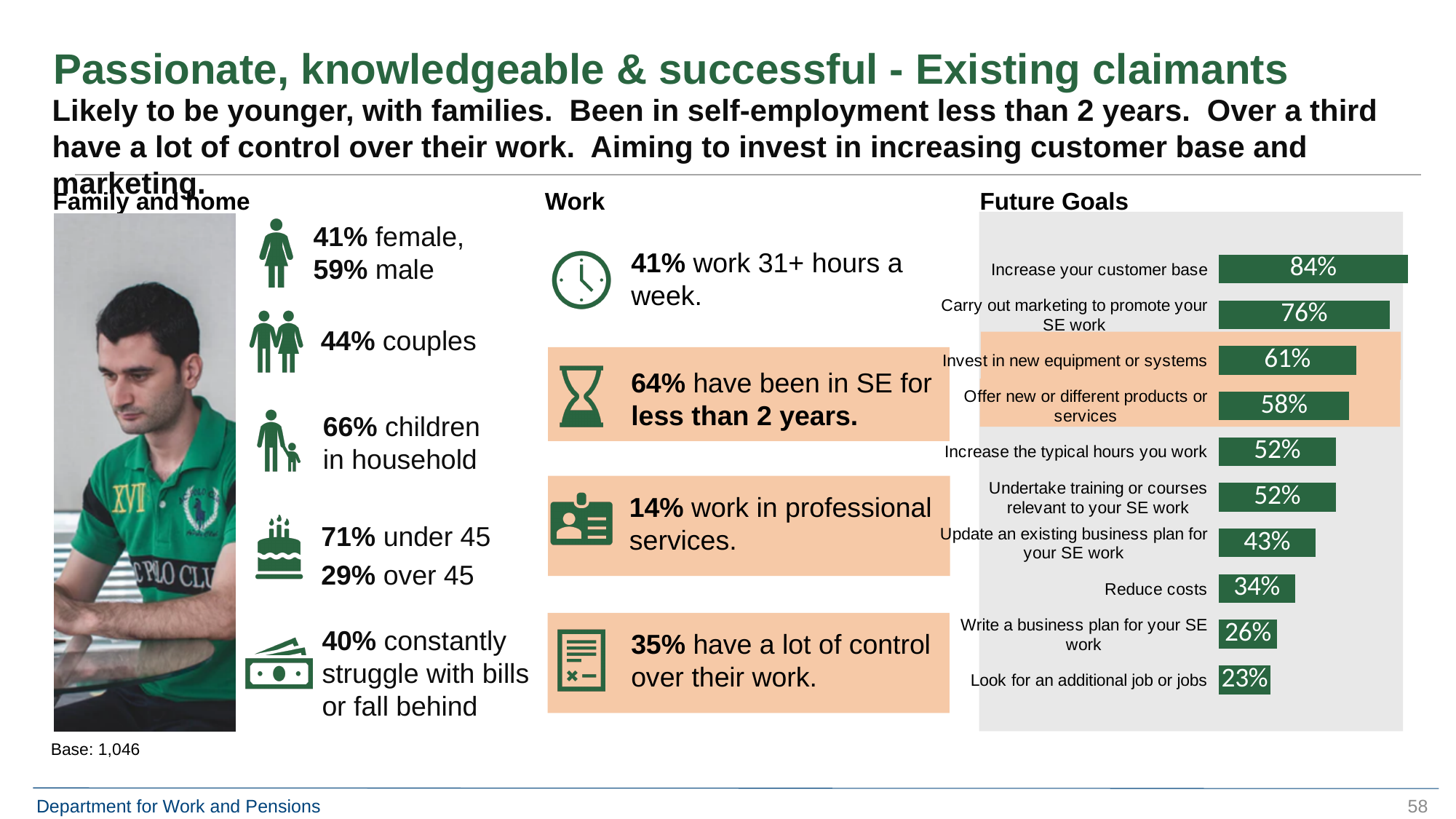
In the Future Goals chart, what is the difference between 'Increase your customer base' and 'Carry out marketing to promote your SE work'? 8% In the Future Goals chart, which goal has the lowest percentage? Look for an additional job or jobs In the Future Goals chart, which goal has the highest percentage? Increase your customer base How many goals are listed in the Future Goals chart? 10 In the Future Goals chart, what percentage is shown for 'Increase your customer base'? 84% In the Future Goals chart, which two goals share the same value of 52%? Increase the typical hours you work; Undertake training or courses relevant to your SE work What is the title of the chart on the right side of the slide? Future Goals In the Future Goals chart, which is larger: 'Reduce costs' or 'Write a business plan for your SE work'? Reduce costs In the Future Goals chart, what is the value for 'Reduce costs'? 34% What type of chart is the Future Goals chart? Bar chart In the Future Goals chart, what percentage is shown for 'Update an existing business plan for your SE work'? 43% In the Future Goals chart, what is the difference between 'Invest in new equipment or systems' and 'Offer new or different products or services'? 3%